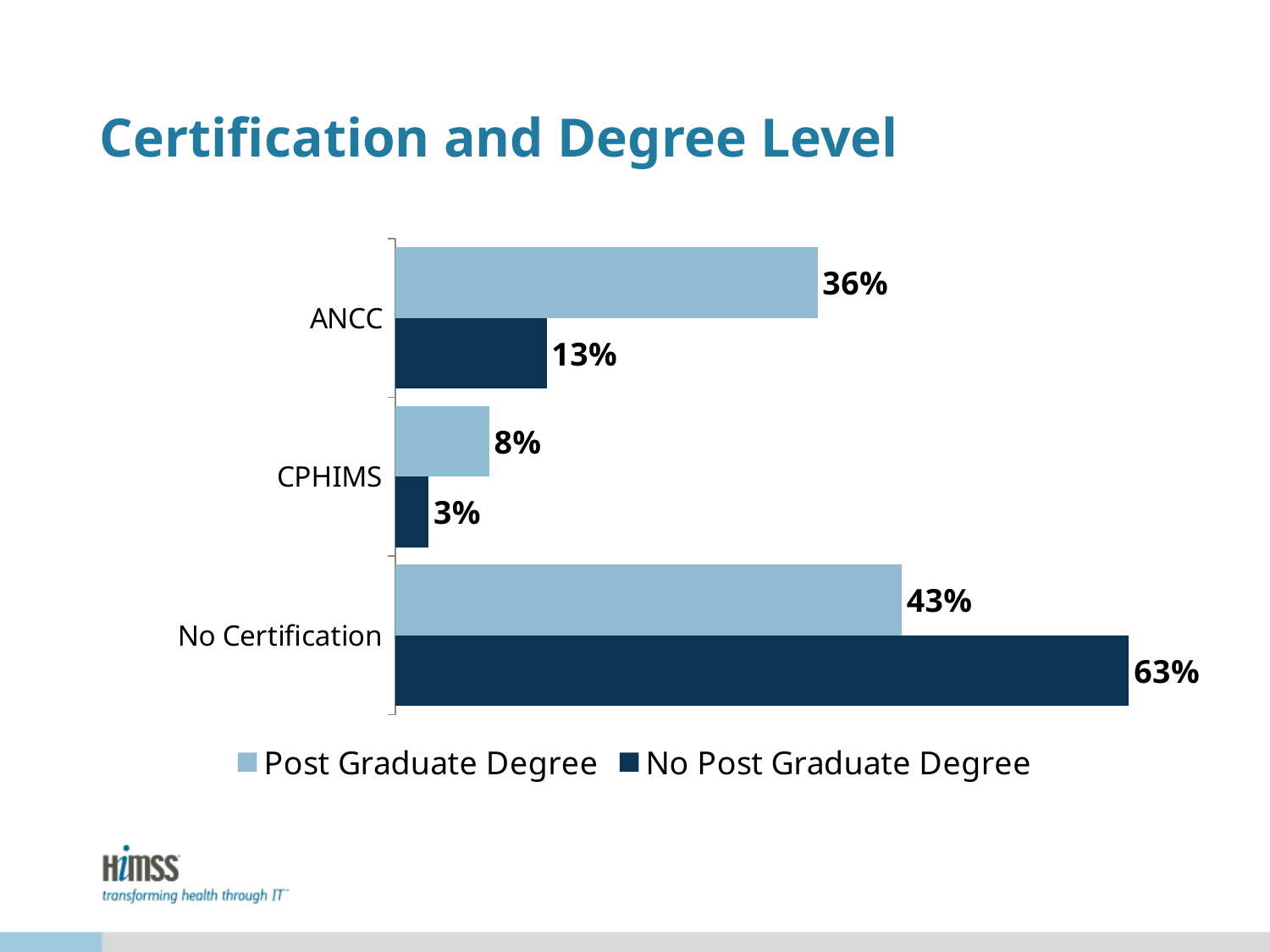
What percentage of respondents with a Post Graduate Degree hold ANCC certification? 36% What is the value for No Post Graduate Degree in the CPHIMS category? 3% Which category has the lowest value for the Post Graduate Degree series? CPHIMS What is the value for No Post Graduate Degree in the No Certification category? 63% How many series does the legend list? 2 For ANCC, which is larger: Post Graduate Degree or No Post Graduate Degree? Post Graduate Degree What is the value for Post Graduate Degree in the CPHIMS category? 8% What is the difference between the Post Graduate Degree and No Post Graduate Degree values for ANCC? 23% What is the difference between the No Post Graduate Degree and Post Graduate Degree values for No Certification? 20% What type of chart is shown on the slide? Bar chart Which category has the highest value for the No Post Graduate Degree series? No Certification How many certification categories are shown on the chart? 3